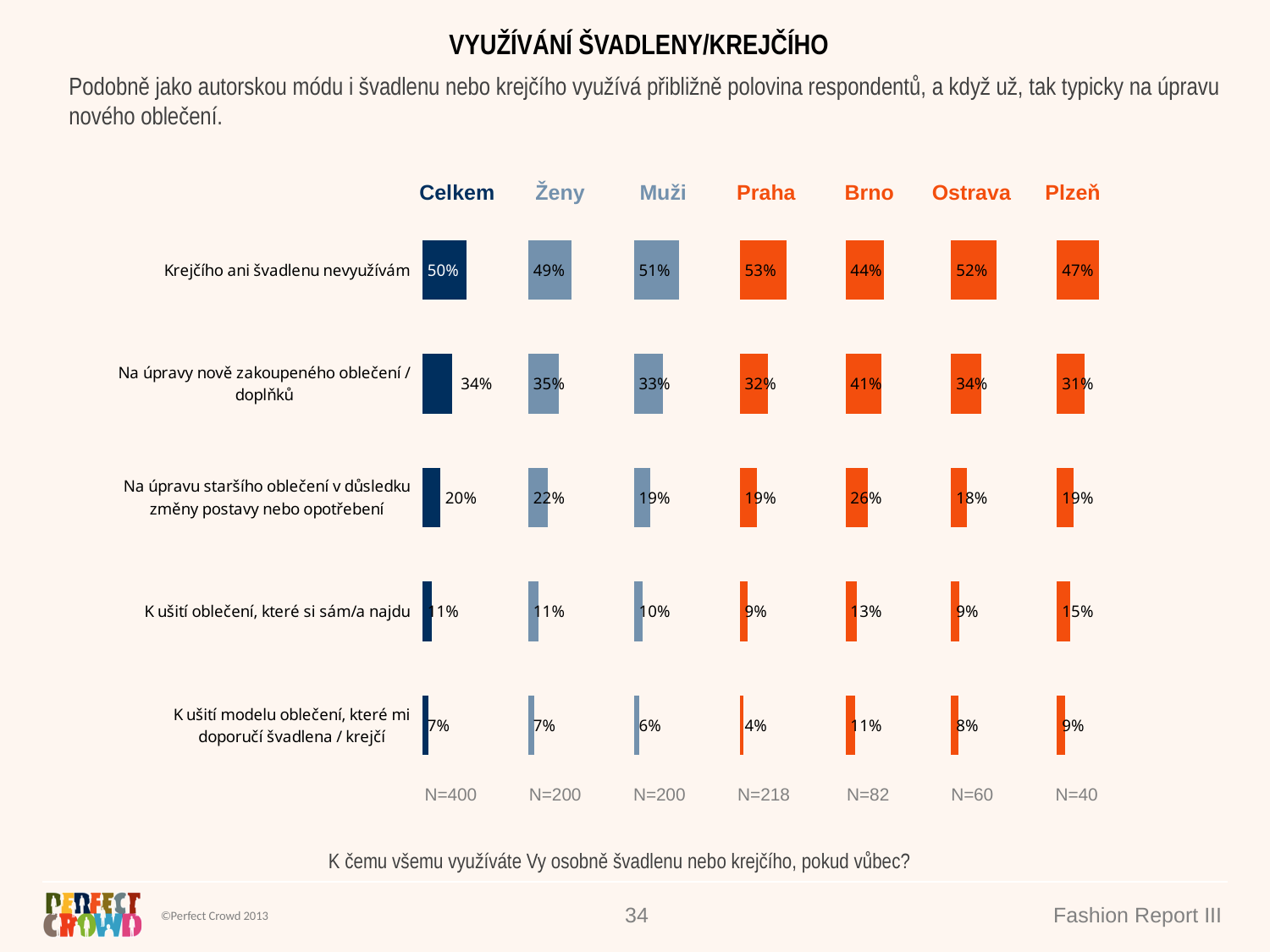
What is the difference between the Brno and Ostrava values for "Na úpravu staršího oblečení v důsledku změny postavy nebo opotřebení"? 8% How many response categories are shown on the chart? 5 What is the value for "Krejčího ani švadlenu nevyužívám" in the Celkem column? 50% What is the value for "Na úpravy nově zakoupeného oblečení / doplňků" in the Brno column? 41% Which column has the lowest value for "K ušití modelu oblečení, které mi doporučí švadlena / krejčí"? Praha What is the value for "K ušití oblečení, které si sám/a najdu" in the Plzeň column? 15% Which city column has the highest value for "Krejčího ani švadlenu nevyužívám"? Praha Which is larger for "Na úpravy nově zakoupeného oblečení / doplňků": the Ženy value or the Muži value? Ženy What is the sample size (N) shown for the Praha column? N=218 What type of chart is shown on the slide? Bar chart How many respondent groups (columns) are shown on the chart? 7 What is the value for "K ušití modelu oblečení, které mi doporučí švadlena / krejčí" in the Praha column? 4%